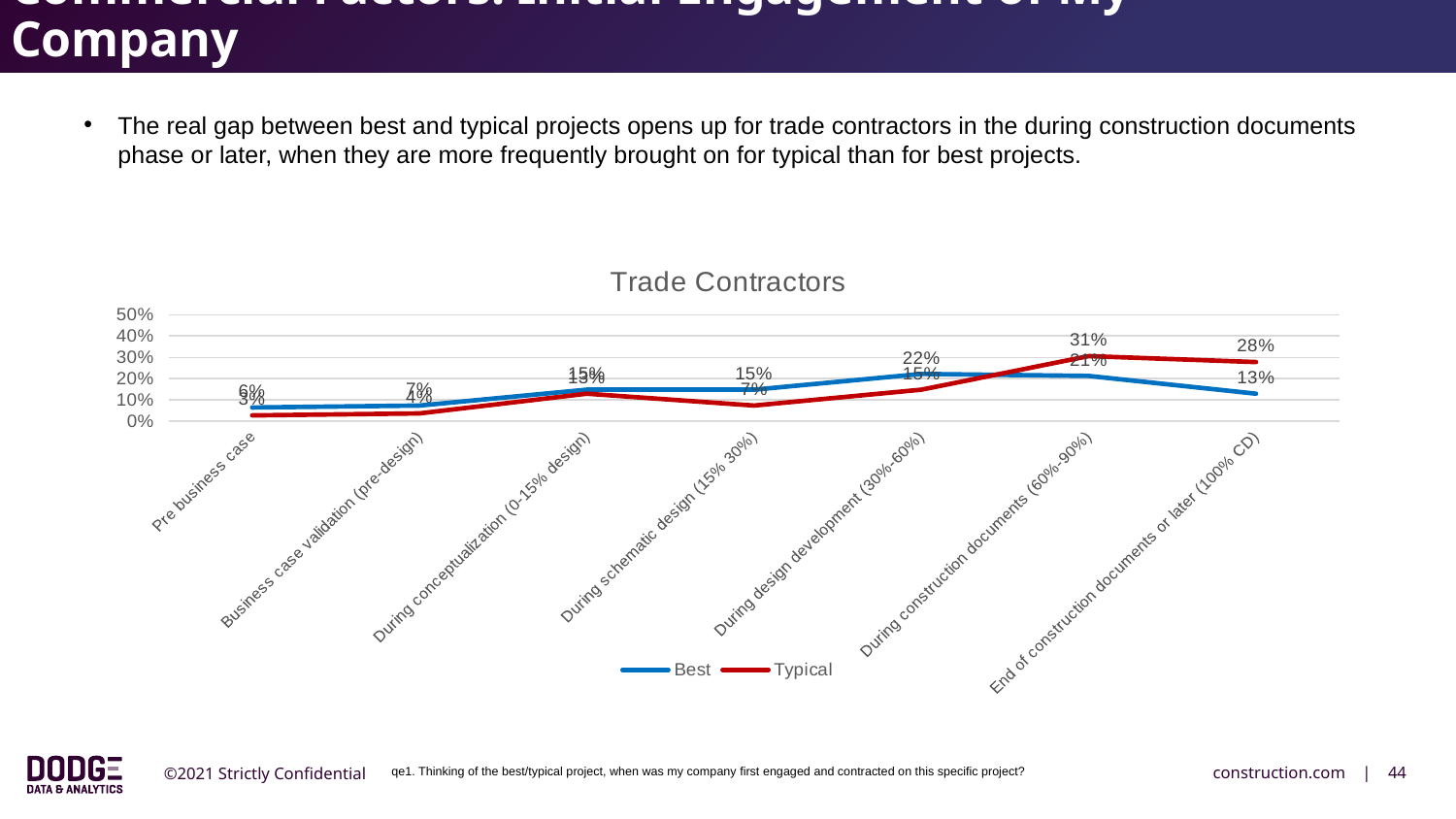
What is the Typical value for "During construction documents (60%-90%)"? 31% At "End of construction documents or later (100% CD)", how much higher is the Typical value than the Best value? 15 percentage points How many series does the legend of the Trade Contractors chart list? 2 What are the two series named in the legend of the Trade Contractors chart? Best and Typical How many phases (categories) are plotted along the x axis of the Trade Contractors chart? 7 In which phase does the Typical series reach its highest value? During construction documents (60%-90%) What is the Best value for "End of construction documents or later (100% CD)"? 13% What kind of chart is shown under the title "Trade Contractors"? Line chart In which phase does the Best series reach its highest value? During design development (30%-60%) What is the Best value for "During design development (30%-60%)"? 22% What is the Typical value for "During schematic design (15%-30%)"? 7% At "During design development (30%-60%)", which series has the larger value, Best or Typical? Best